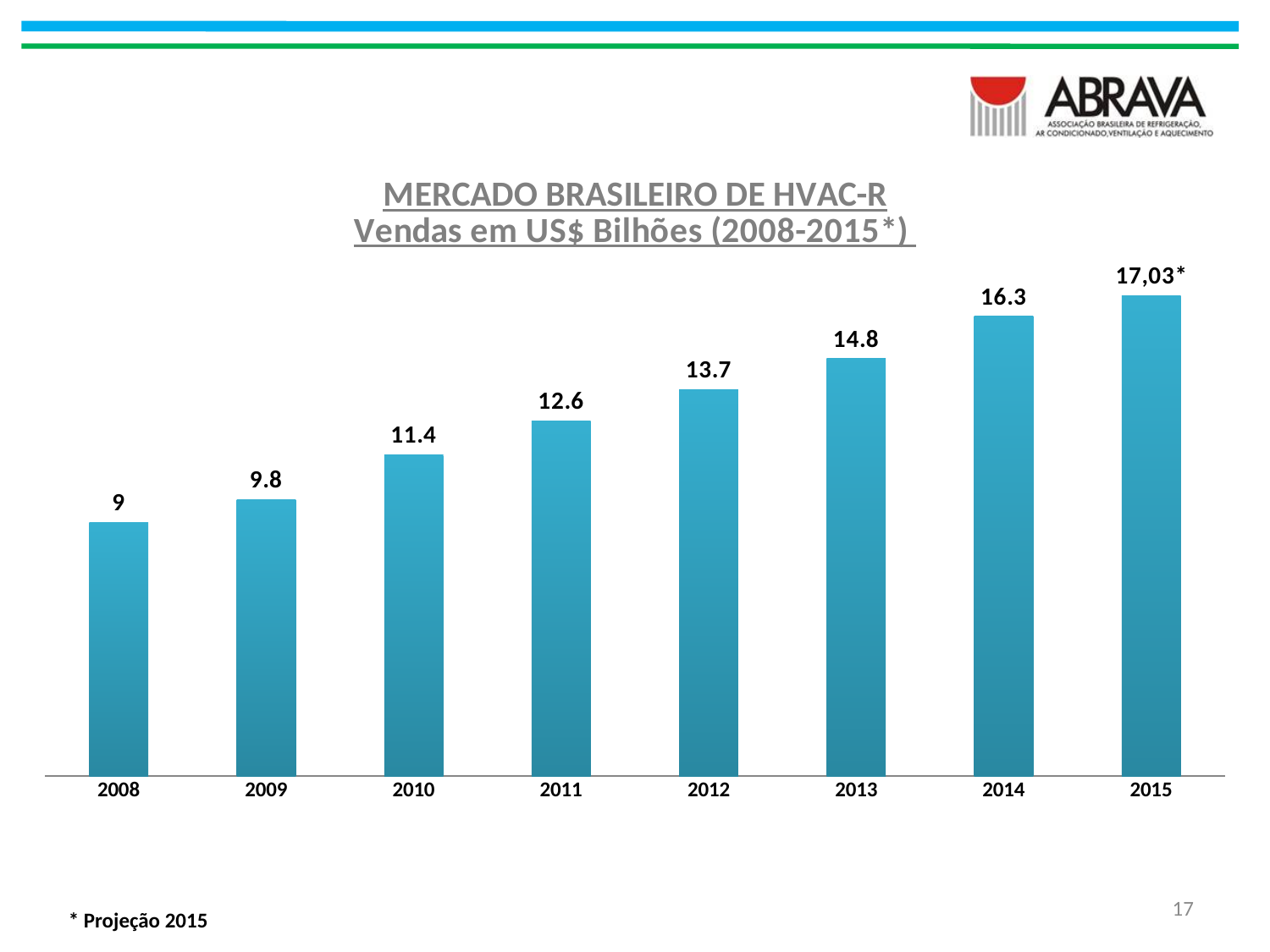
Which year has the highest value? 2015 What kind of chart is this? bar chart Do the values rise or fall from 2008 to 2015? rise Which year has the lowest value? 2008 What is the difference between the values for 2010 and 2008? 2.4 How many years are shown on the x axis? 8 What is the value shown for 2015? 17,03* What is the value for 2008? 9 What is the value for 2014? 16.3 What is the value for 2011? 12.6 Which is larger, the value for 2009 or the value for 2012? 2012 What is the difference between the values for 2013 and 2012? 1.1